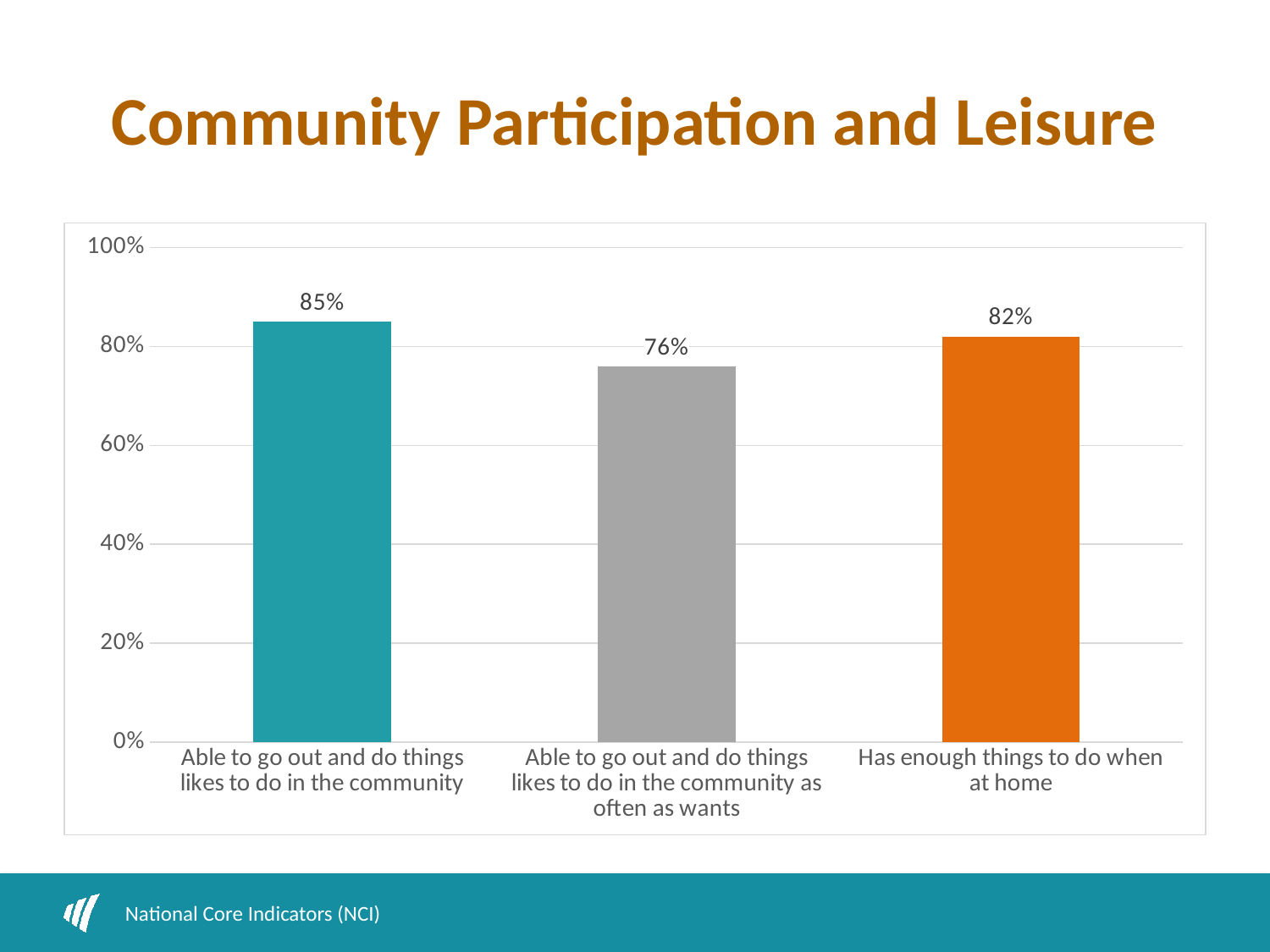
Which category has the lowest value? Able to go out and do things likes to do in the community as often as wants What is the value for "Has enough things to do when at home"? 82% What kind of chart is shown on the slide? Bar chart What is the value for "Able to go out and do things likes to do in the community as often as wants"? 76% What is the value for "Able to go out and do things likes to do in the community"? 85% Is the value for "Able to go out and do things likes to do in the community as often as wants" greater or less than 80%? less How many categories are shown in the chart? 3 Which category has the highest value? Able to go out and do things likes to do in the community What colour is the bar for "Has enough things to do when at home"? Orange Which is larger: the value for "Has enough things to do when at home" or the value for "Able to go out and do things likes to do in the community as often as wants"? Has enough things to do when at home What is the difference between the values for "Able to go out and do things likes to do in the community" and "Able to go out and do things likes to do in the community as often as wants"? 9% What is the difference between the values for "Has enough things to do when at home" and "Able to go out and do things likes to do in the community as often as wants"? 6%